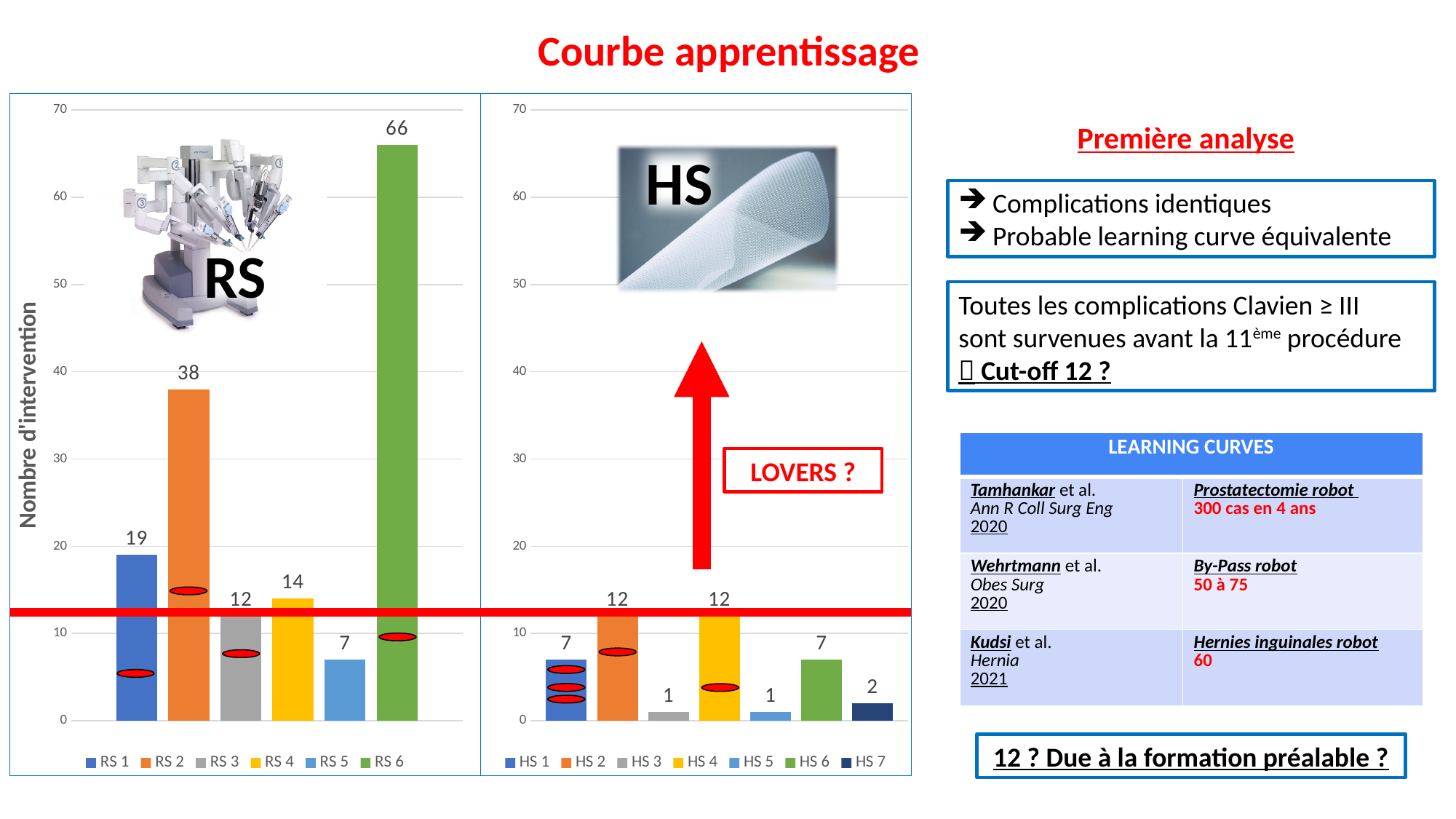
In the left (RS) chart, how many series does the legend list? 6 In the right (HS) chart, which is larger, the value for HS 1 or the value for HS 2? HS 2 In the left (RS) chart, what is the value for RS 2? 38 In the left (RS) chart, which series has the lowest value? RS 5 In the right (HS) chart, what is the value for HS 6? 7 In the right (HS) chart, what is the difference between the values for HS 4 and HS 5? 11 What kind of chart is the left (RS) chart? Bar chart In the left (RS) chart, which series has the highest value? RS 6 In the right (HS) chart, how many series does the legend list? 7 In the left (RS) chart, what is the difference between the values for RS 6 and RS 2? 28 What is the y-axis label of the left (RS) chart? Nombre d'intervention In the right (HS) chart, what is the value for HS 7? 2